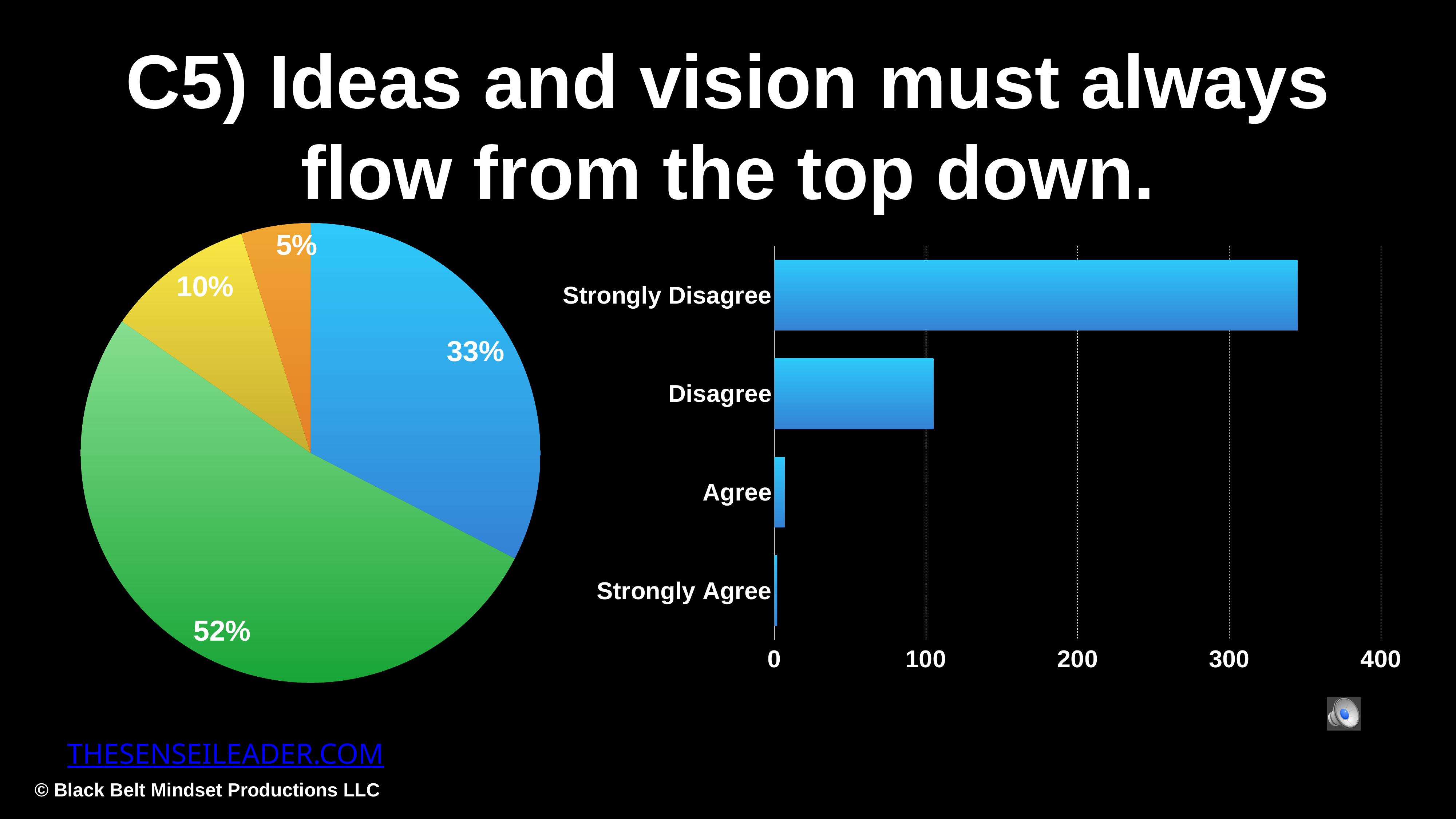
How many slices does the pie chart have? 4 What kind of chart is on the left side of the slide? pie chart How many categories are shown in the bar chart? 4 In the pie chart, what percentage is shown on the largest slice? 52% In the pie chart, what is the difference between the largest slice (52%) and the smallest slice (5%)? 47% In the bar chart, which category has the shortest bar? Strongly Agree In the bar chart, is the value for Agree greater or less than 100? less In the pie chart, what percentage is shown on the smallest slice? 5% In the bar chart, which category has the longest bar? Strongly Disagree What kind of chart is on the right side of the slide? bar chart In the pie chart, what percentage is shown on the green slice? 52% In the bar chart, is the value for Strongly Disagree greater or less than 300? greater